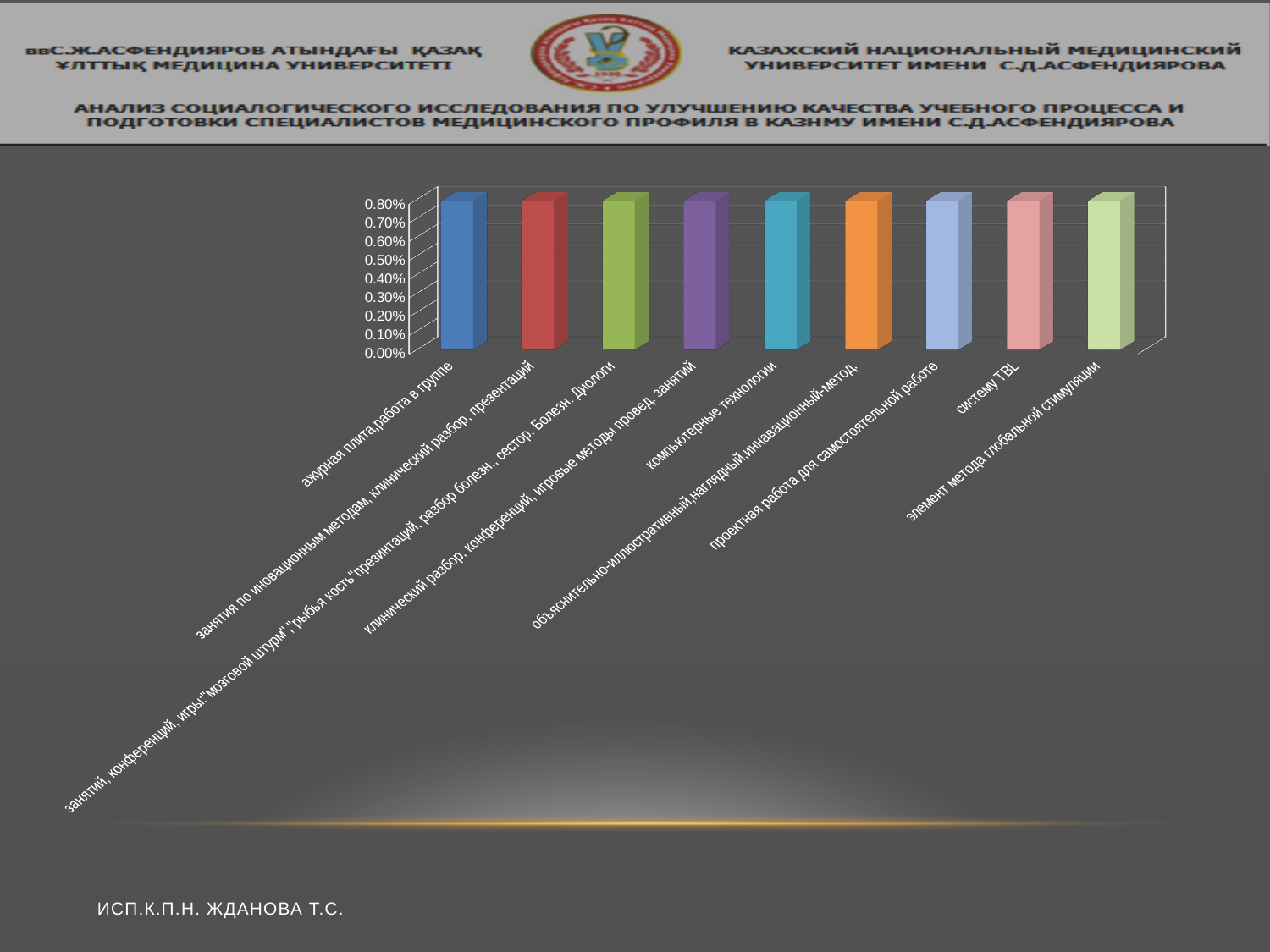
Do the bar values rise, fall, or stay the same across the categories from left to right? stay the same Is the value for "компьютерные технологии" greater or less than 0.40%? greater Is the value for "систему TBL" greater or less than 0.50%? greater What is the label of the first (leftmost) category on the x axis? ажурная плита,работа в группе What is the label of the last (rightmost) category on the x axis? элемент метода глобальной стимуляции Is the value for "элемент метода глобальной стимуляции" greater or less than 0.60%? greater What is the highest value shown on the vertical axis? 0.80% What kind of chart is shown on the slide? bar chart How many bars (categories) does the chart show? 9